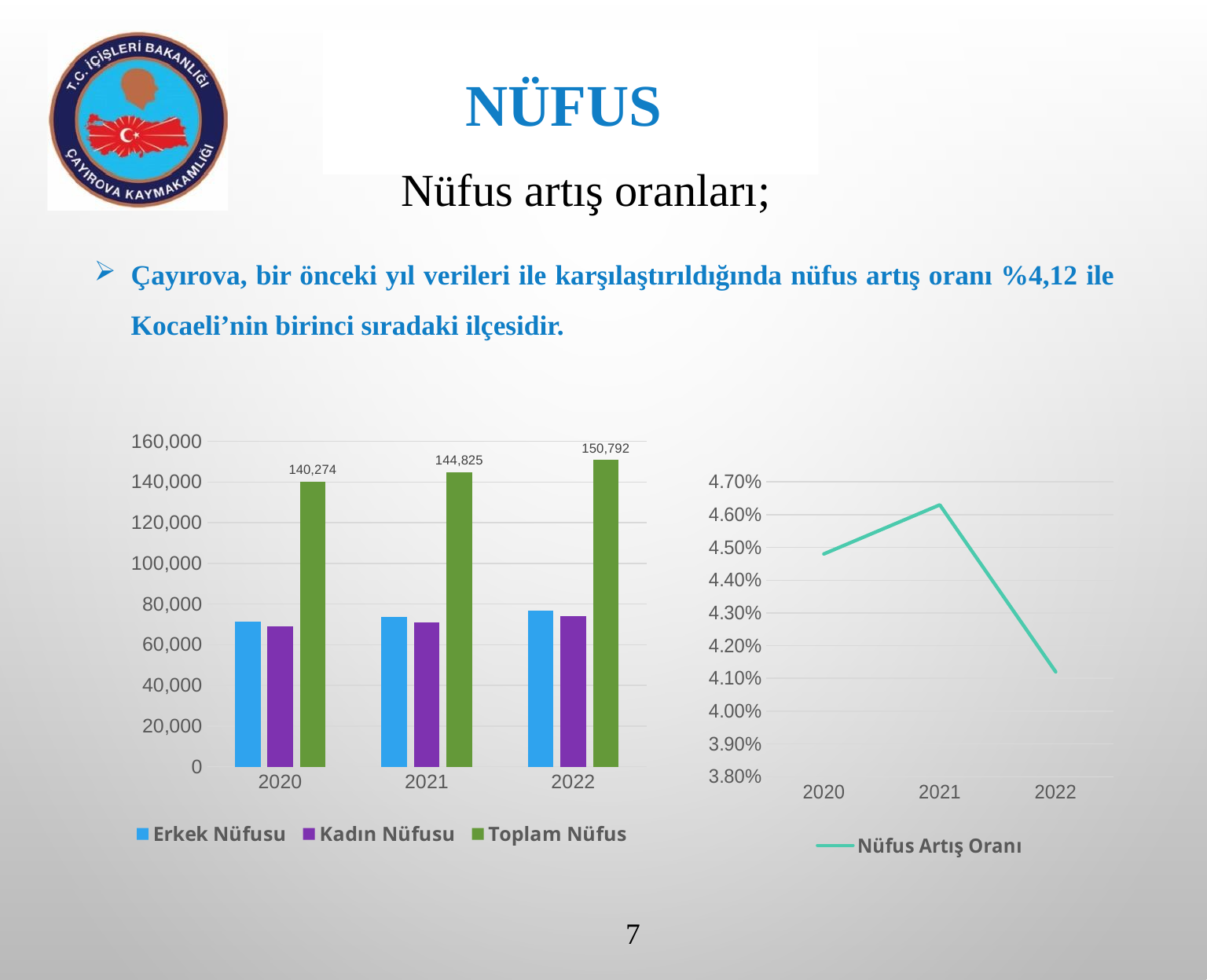
In the left bar chart, is the Erkek Nüfusu value for 2022 greater or less than 60,000? greater In the right line chart, which year has the lowest Nüfus Artış Oranı? 2022 In the left bar chart, which year has the highest Toplam Nüfus? 2022 In the left bar chart, what is the Toplam Nüfus value for 2020? 140,274 In the right line chart, how many years are plotted on the x axis? 3 In the left bar chart, what is the Toplam Nüfus value for 2021? 144,825 In the left bar chart, what is the difference between the Toplam Nüfus for 2021 and 2020? 4,551 In the left bar chart, how many series does the legend list? 3 In the left bar chart, what is the difference between the Toplam Nüfus for 2022 and 2021? 5,967 In the right line chart, is the Nüfus Artış Oranı for 2021 greater or less than 4.50%? greater In the left bar chart, what is the Toplam Nüfus value for 2022? 150,792 What kind of chart is the chart on the right of the slide? Line chart